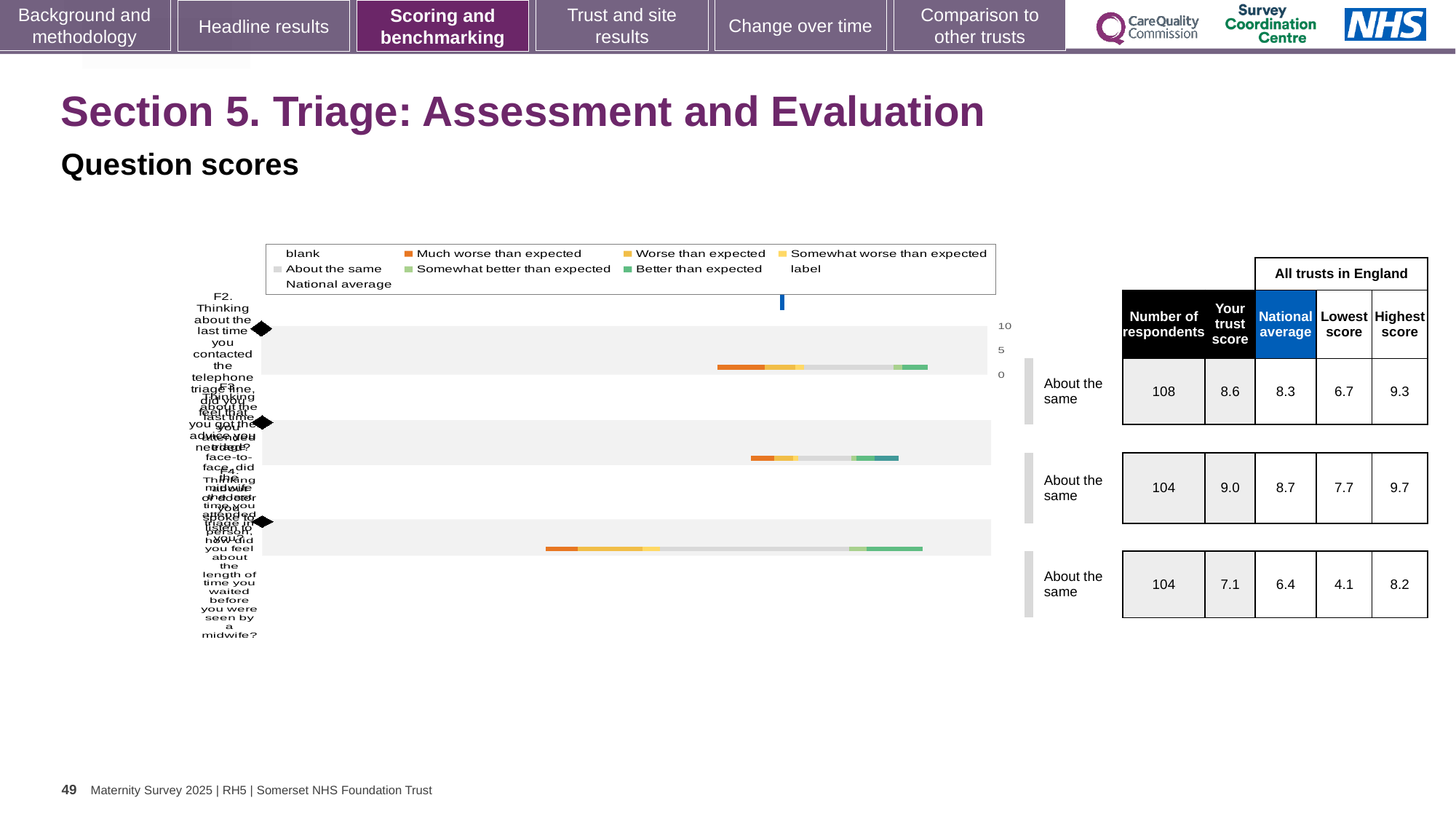
For the third row (F4), which is larger: the trust score or the national average? the trust score (7.1) How many survey questions (rows) are plotted in the chart? 3 What is the difference between the trust score and the national average for the first row (F2)? 0.3 Which row has the lowest 'Your trust score'? F4 (third row) What is the highest score among all trusts in England for the third row (F4)? 8.2 What benchmark category is shown for all three rows? About the same What is the national average for the second row (F3)? 8.7 What kind of chart is shown on the slide? bar chart What is the 'Your trust score' for the first row (F2, about the telephone triage line)? 8.6 What colour does the legend use for 'Much worse than expected'? orange Which row has the highest 'Your trust score'? F3 (second row) How many respondents are listed for the third row (F4, about the length of time waited before being seen by a midwife)? 104